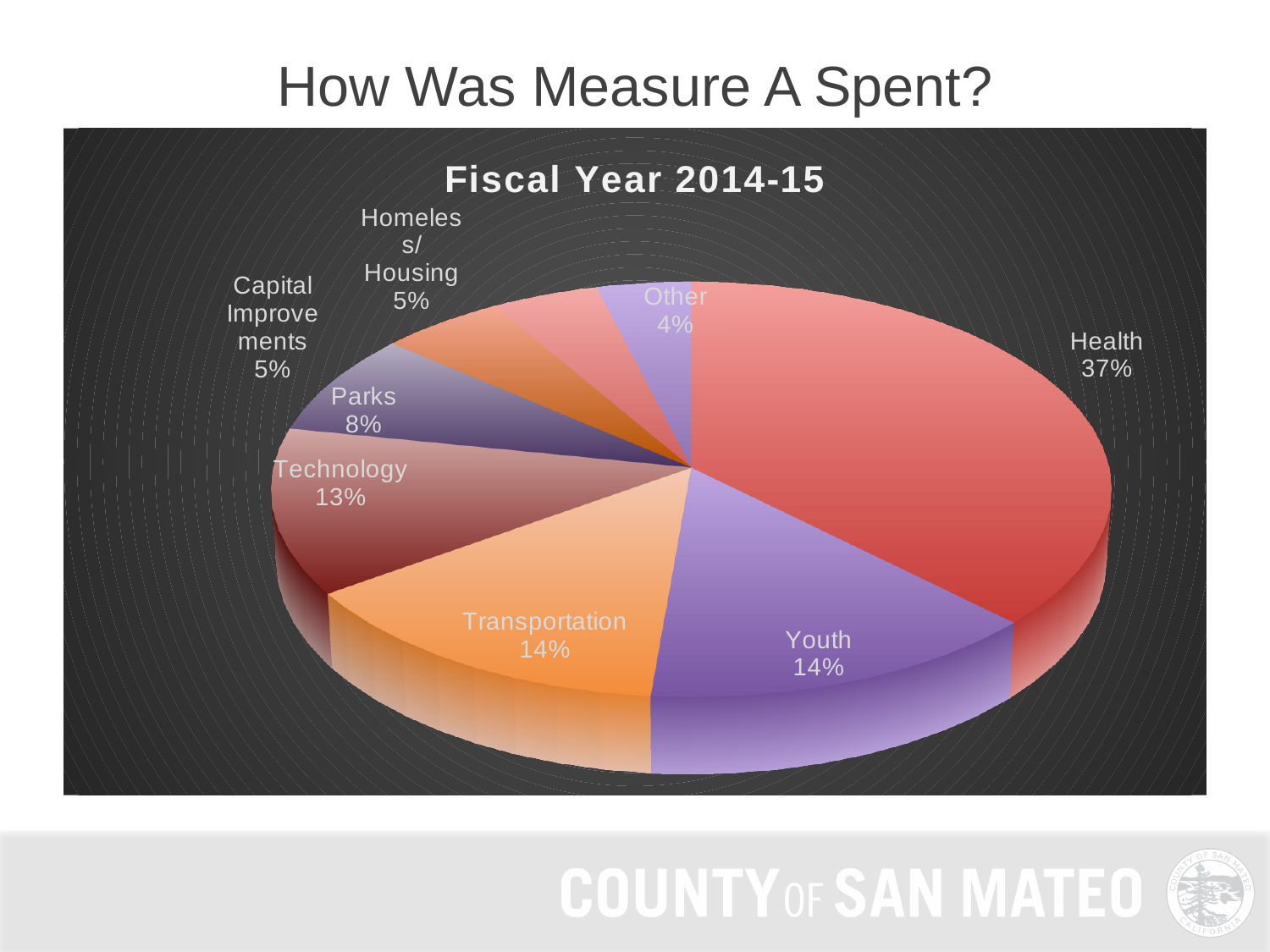
What percentage of the pie is labelled Technology? 13% What share of Measure A spending went to Health in Fiscal Year 2014-15? 37% What is the title of the chart? Fiscal Year 2014-15 Which is larger, the Technology slice or the Parks slice? Technology Which category has the smallest slice of the pie? Other What share does the Parks slice represent? 8% What is the difference in percentage points between Health and Youth? 23 Which category has the largest slice of the pie? Health What percentage is shown for Homeless/Housing? 5% What kind of chart is shown on the slide? Pie chart How many categories are shown in the pie chart? 8 What percentage is shown for Other? 4%